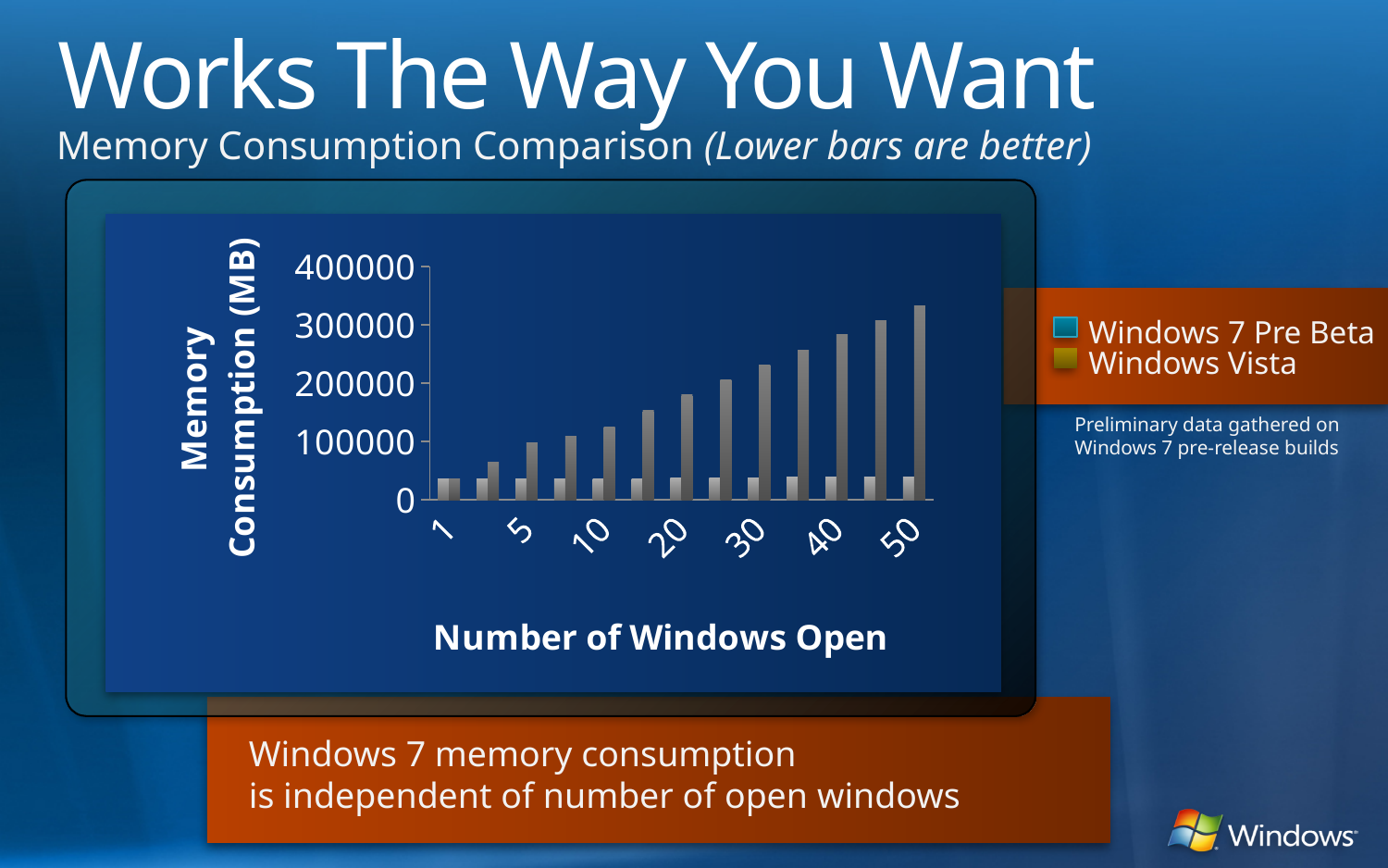
Do the taller bars in each group rise or fall as the number of windows open increases along the x axis? rise What kind of chart is shown on the slide? bar chart At which x-axis value does the tallest bar in the chart appear? 50 Is the taller bar at 20 windows open greater or less than 100000? greater Is the taller bar at 1 window open greater or less than 100000? less How many series does the chart legend list? 2 Is the tallest bar in the chart greater or less than 400000? less What are the two series named in the chart legend? Windows 7 Pre Beta and Windows Vista What is the title of the chart's x axis? Number of Windows Open